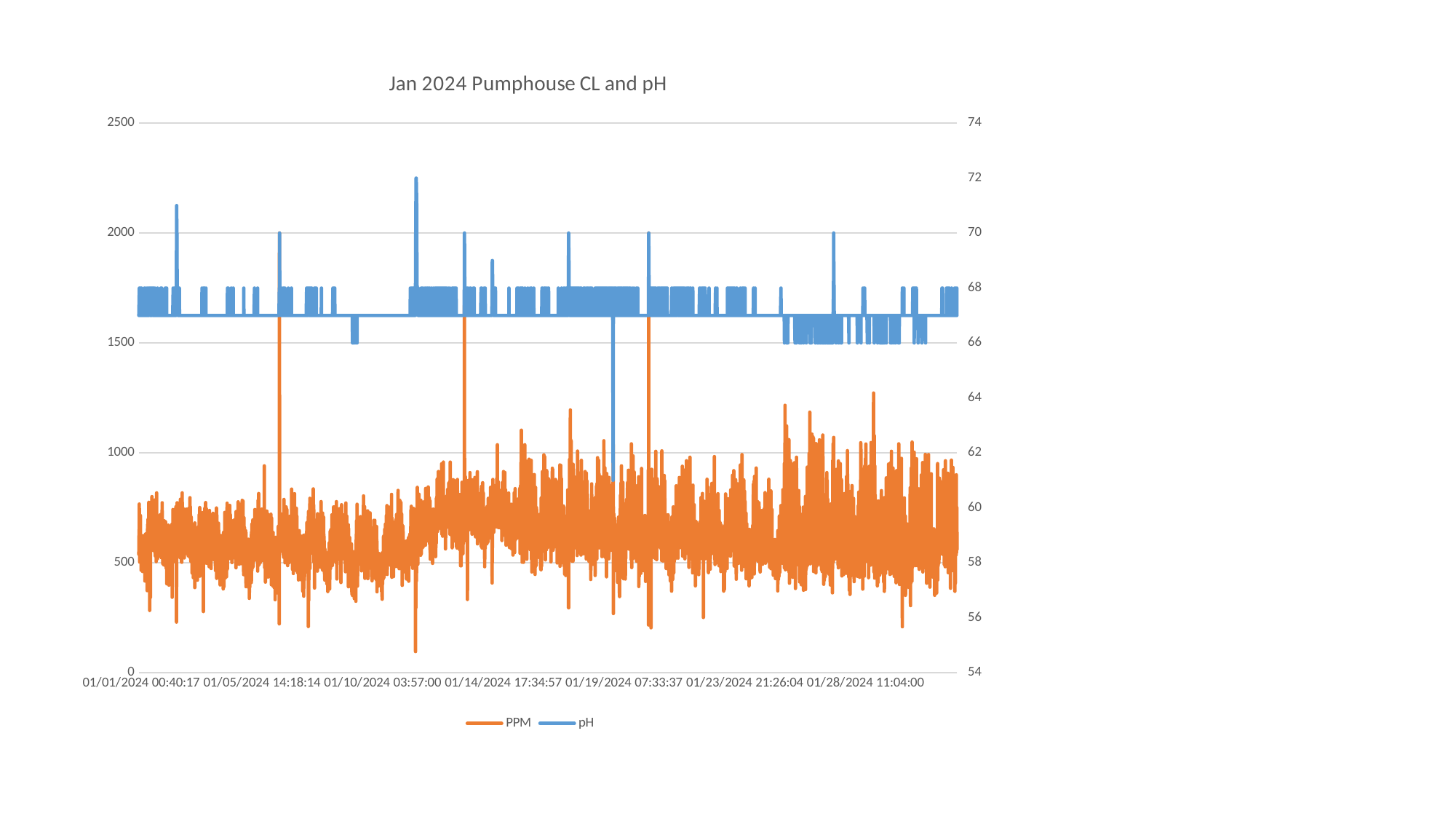
How many series does the legend list? 2 What is the title of the chart? Jan 2024 Pumphouse CL and pH Which series is drawn in orange? PPM What kind of chart is shown on the slide? line chart Is the highest PPM spike greater or less than 1000 on the left axis? greater Does the typical level of the PPM series rise or fall from the start of January to the end? rise Is the lowest PPM value greater or less than 500 on the left axis? less Does the PPM series ever reach 2000 on the left axis? no